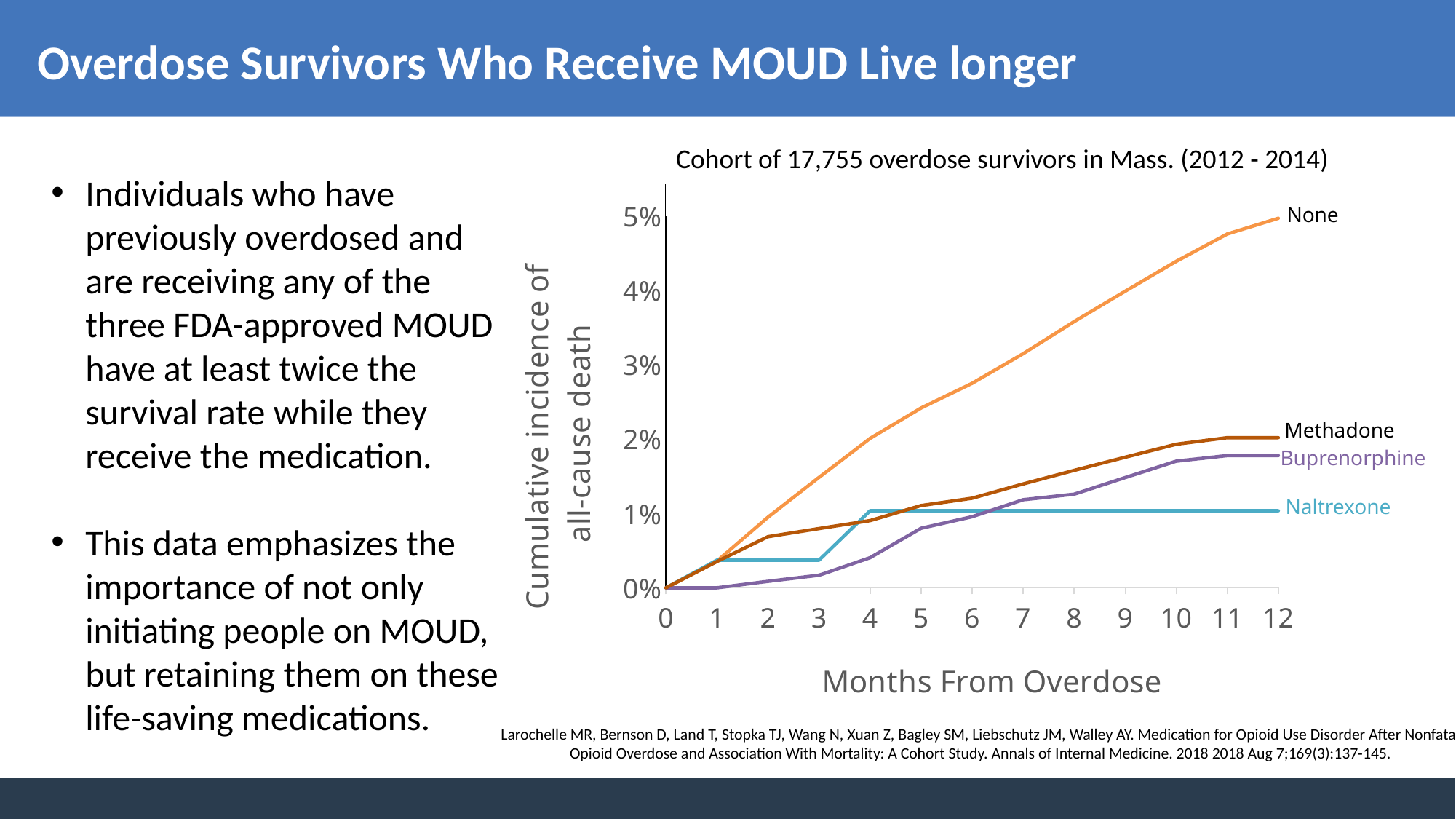
What is the label of the x axis? Months From Overdose How many series (lines) are plotted on the chart? 4 Is the value for Methadone at month 12 greater or less than 3%? less Is the value for None at month 6 greater or less than 2%? greater Is the value for Buprenorphine at month 3 greater or less than 1%? less What is the title of the chart? Cohort of 17,755 overdose survivors in Mass. (2012 - 2014) At month 12, which is larger: the value for Methadone or the value for Naltrexone? Methadone Which series has the lowest cumulative incidence of all-cause death at month 12? Naltrexone Does the None line rise or fall as months from overdose increase? rise Which series has the highest cumulative incidence of all-cause death at month 12? None What kind of chart is shown on the slide? line chart